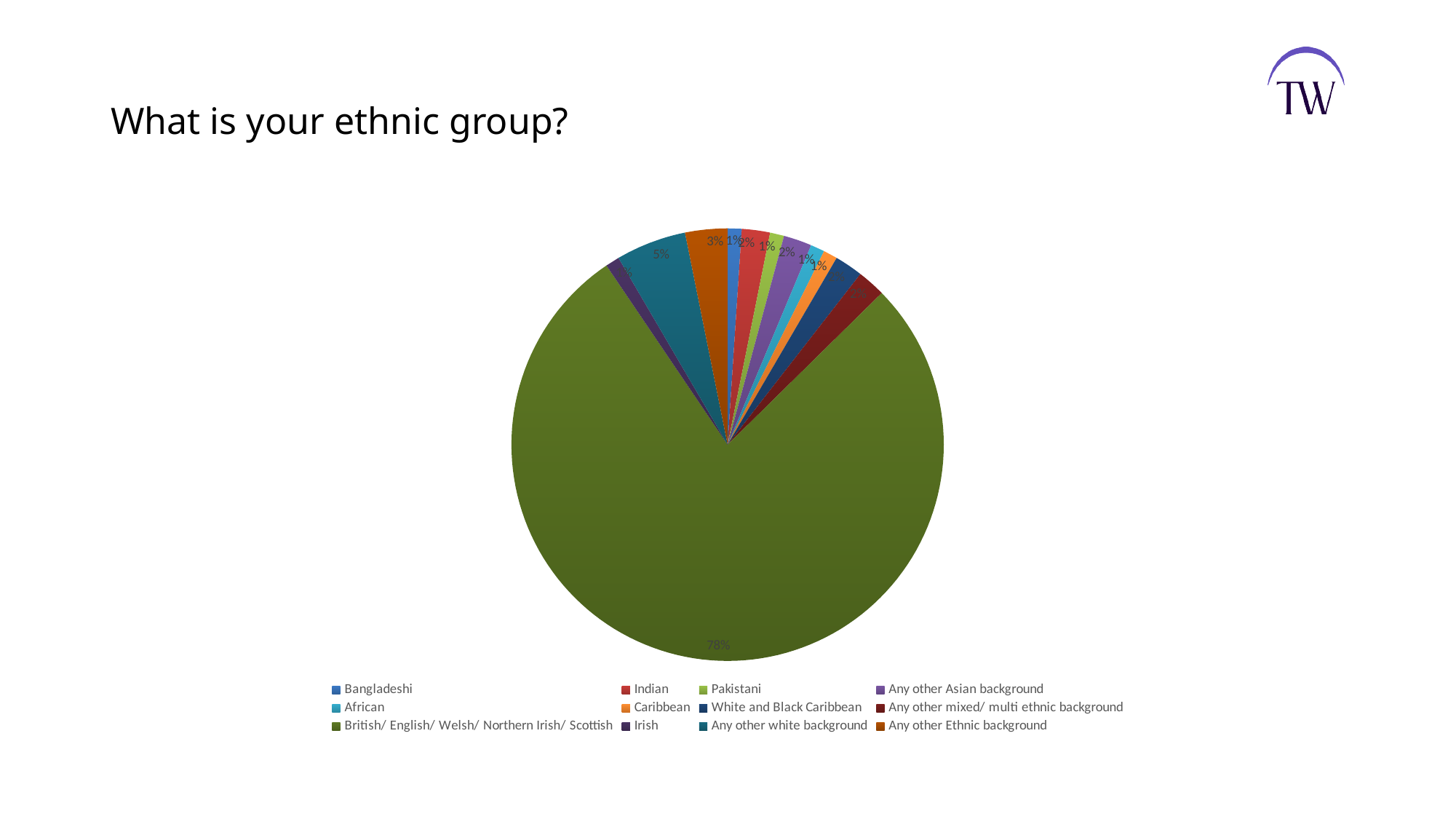
Which is larger, the share for Any other white background or the share for Any other Ethnic background? Any other white background What colour is the largest slice of the pie? green What share of the pie is Any other white background? 5% What is the difference in percentage points between the British/ English/ Welsh/ Northern Irish/ Scottish share and the Any other white background share? 73 percentage points What is the title of the slide containing the chart? What is your ethnic group? What share of the pie is Any other Ethnic background? 3% What kind of chart is shown on the slide? pie chart What share of the pie is British/ English/ Welsh/ Northern Irish/ Scottish? 78% What is the difference in percentage points between the Any other white background share and the Any other Ethnic background share? 2 percentage points How many ethnic groups does the legend list? 12 Which ethnic group has the largest share of the pie? British/ English/ Welsh/ Northern Irish/ Scottish